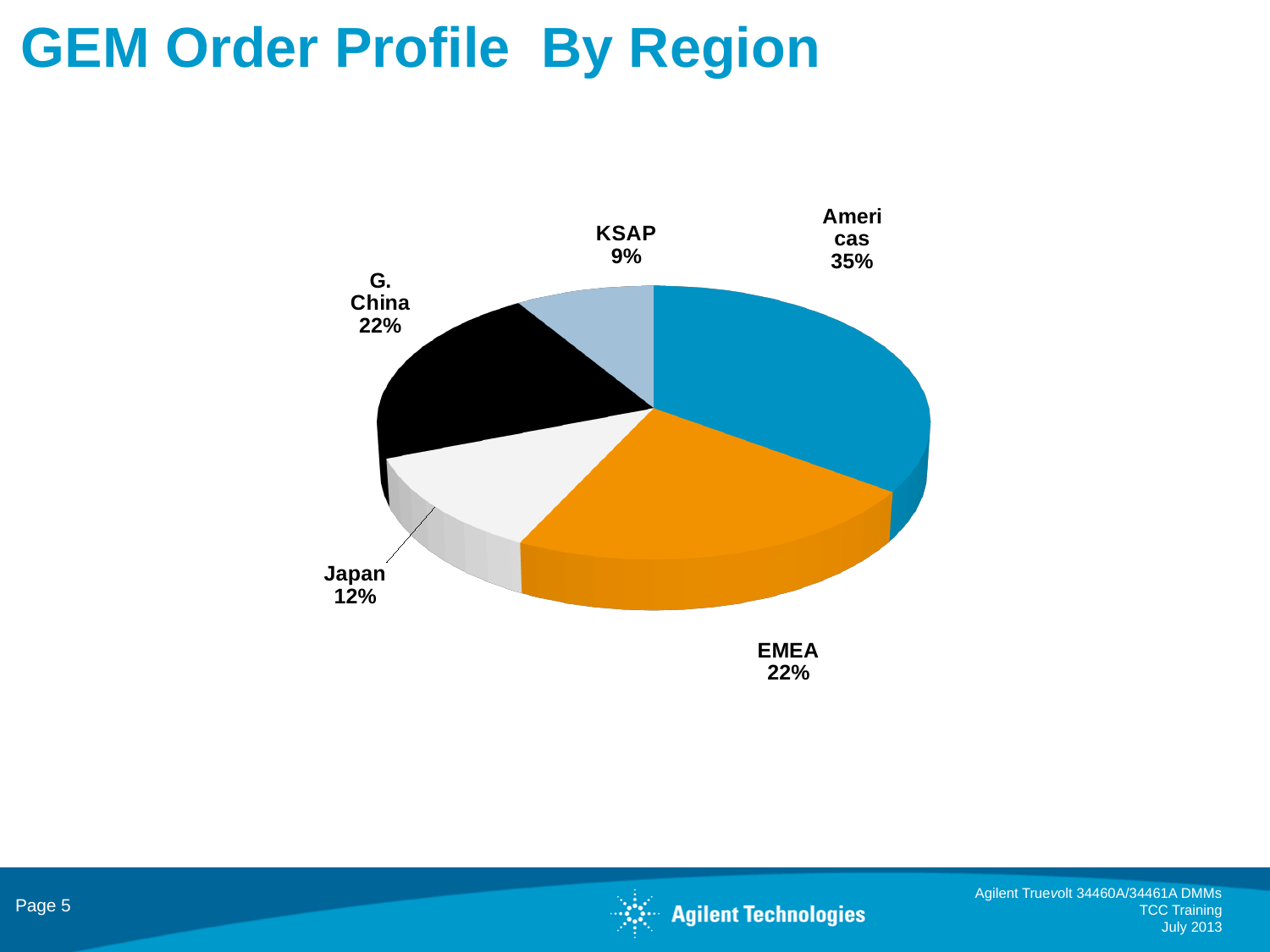
What share of GEM orders comes from EMEA? 22% What share of GEM orders comes from KSAP? 9% Which region has the largest share of GEM orders? Americas What share of GEM orders comes from G. China? 22% What is the difference in share between the Americas and Japan? 23% What share of GEM orders comes from the Americas? 35% What is the title of the chart on the slide? GEM Order Profile By Region Which region has the smallest share of GEM orders? KSAP What kind of chart is shown on the slide? pie chart Which has a larger share of GEM orders, EMEA or Japan? EMEA How many regions are shown in the pie chart? 5 What share of GEM orders comes from Japan? 12%